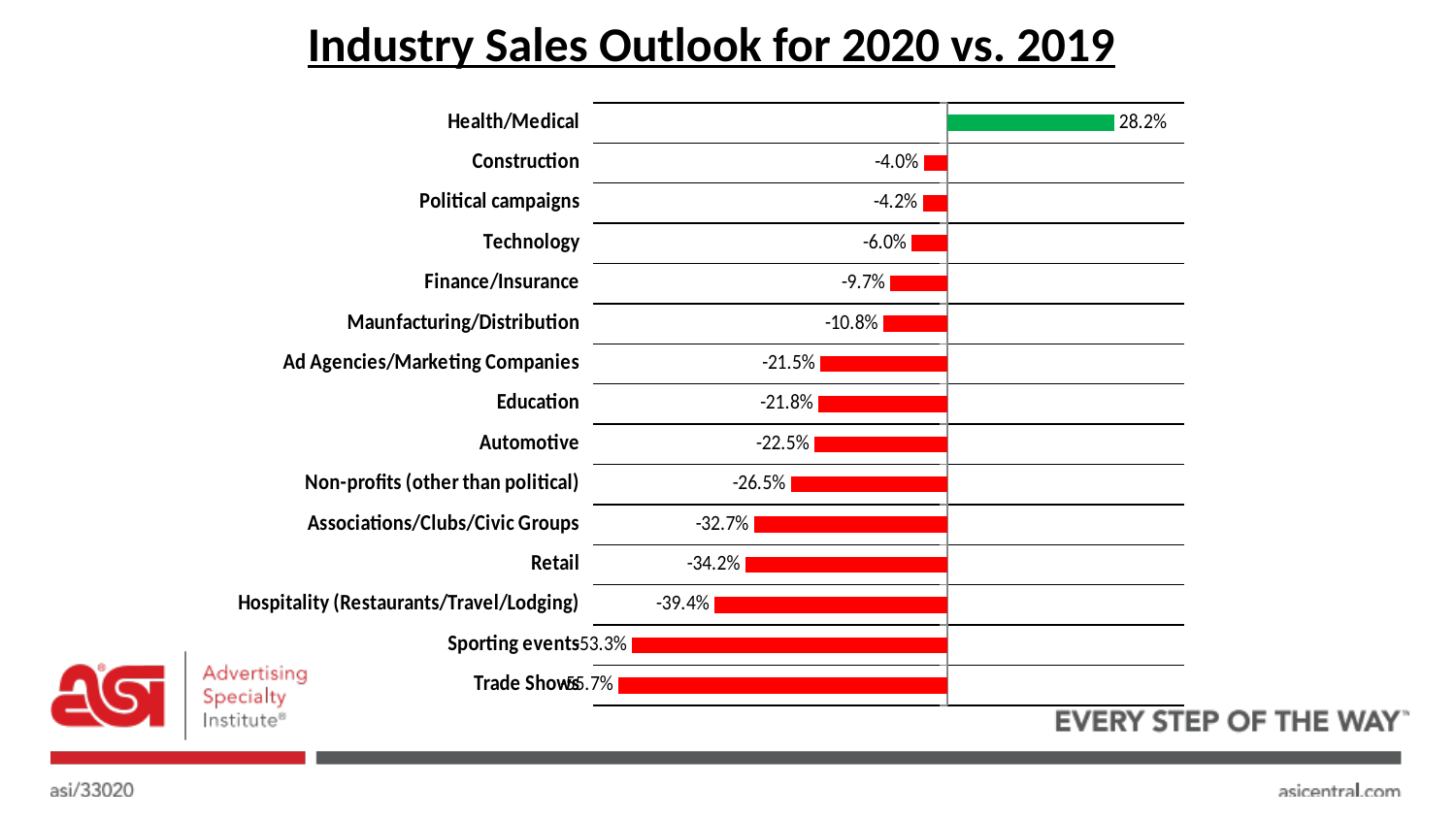
Which category has the highest value? Health/Medical What kind of chart is shown on the slide? Bar chart What is the value for Hospitality (Restaurants/Travel/Lodging)? -39.4% What is the difference between the values for Retail and Hospitality (Restaurants/Travel/Lodging)? 5.2 percentage points What is the value for Non-profits (other than political)? -26.5% What is the value for Finance/Insurance? -9.7% What is the value for Retail? -34.2% Which category has the lowest value? Trade Shows What is the value for Health/Medical? 28.2% How many categories are shown in the chart? 15 Which has the larger value, Technology or Automotive? Technology What is the title of the chart? Industry Sales Outlook for 2020 vs. 2019